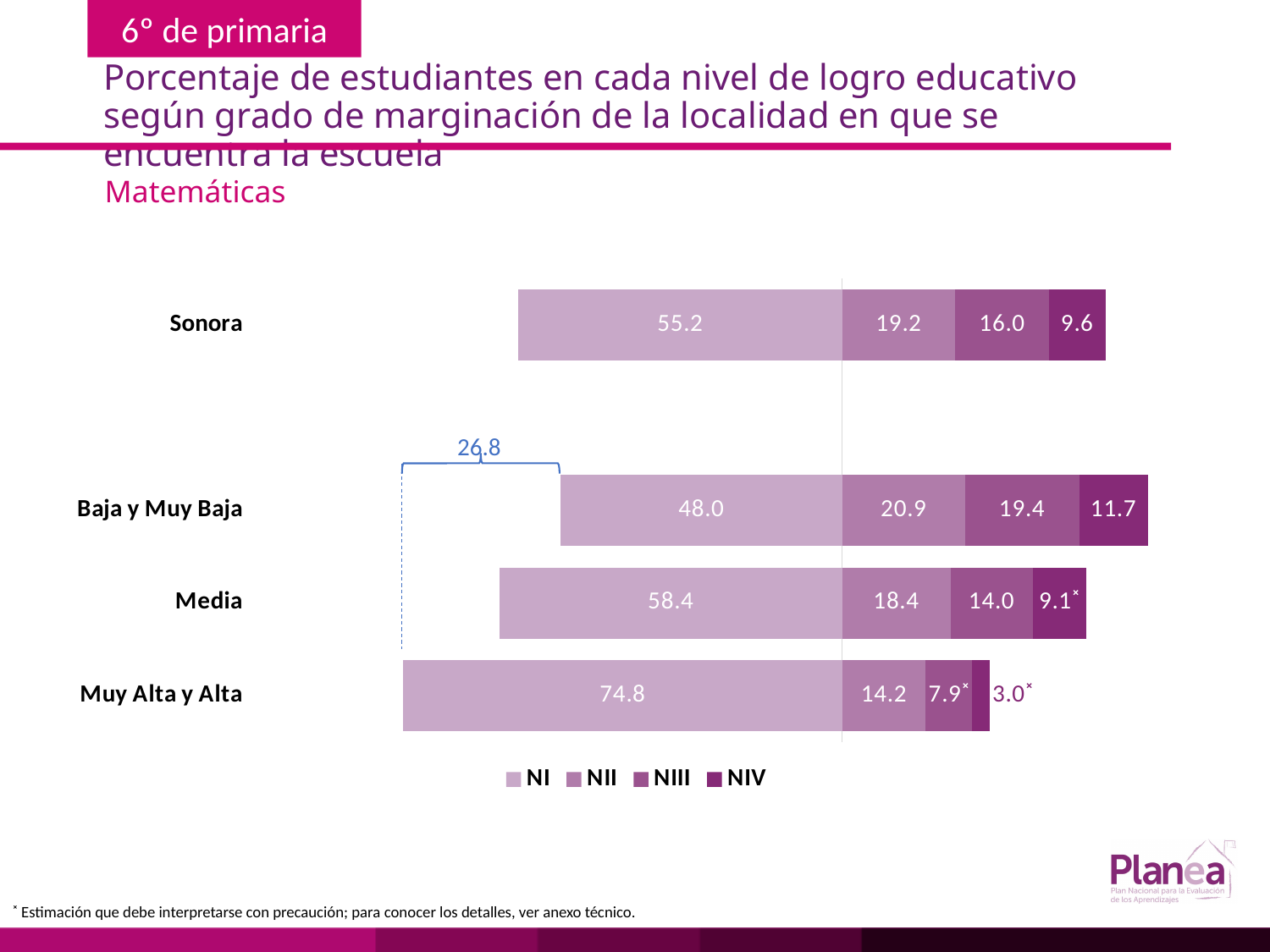
What is the NIV value for Baja y Muy Baja? 11.7 Which category has the lowest NIV value? Muy Alta y Alta What is the NI value for Sonora? 55.2 What is the difference between the NI values for Muy Alta y Alta and Baja y Muy Baja? 26.8 How many categories are plotted on the chart? 4 How many series does the legend list? 4 Which is larger, the NIII value for Sonora or the NIII value for Media? Sonora What type of chart is shown on the slide? Stacked bar chart What is the NIII value for Muy Alta y Alta? 7.9 Which category has the highest NI value? Muy Alta y Alta What is the NII value for Media? 18.4 What is the total of the stacked bar for Sonora? 100.0